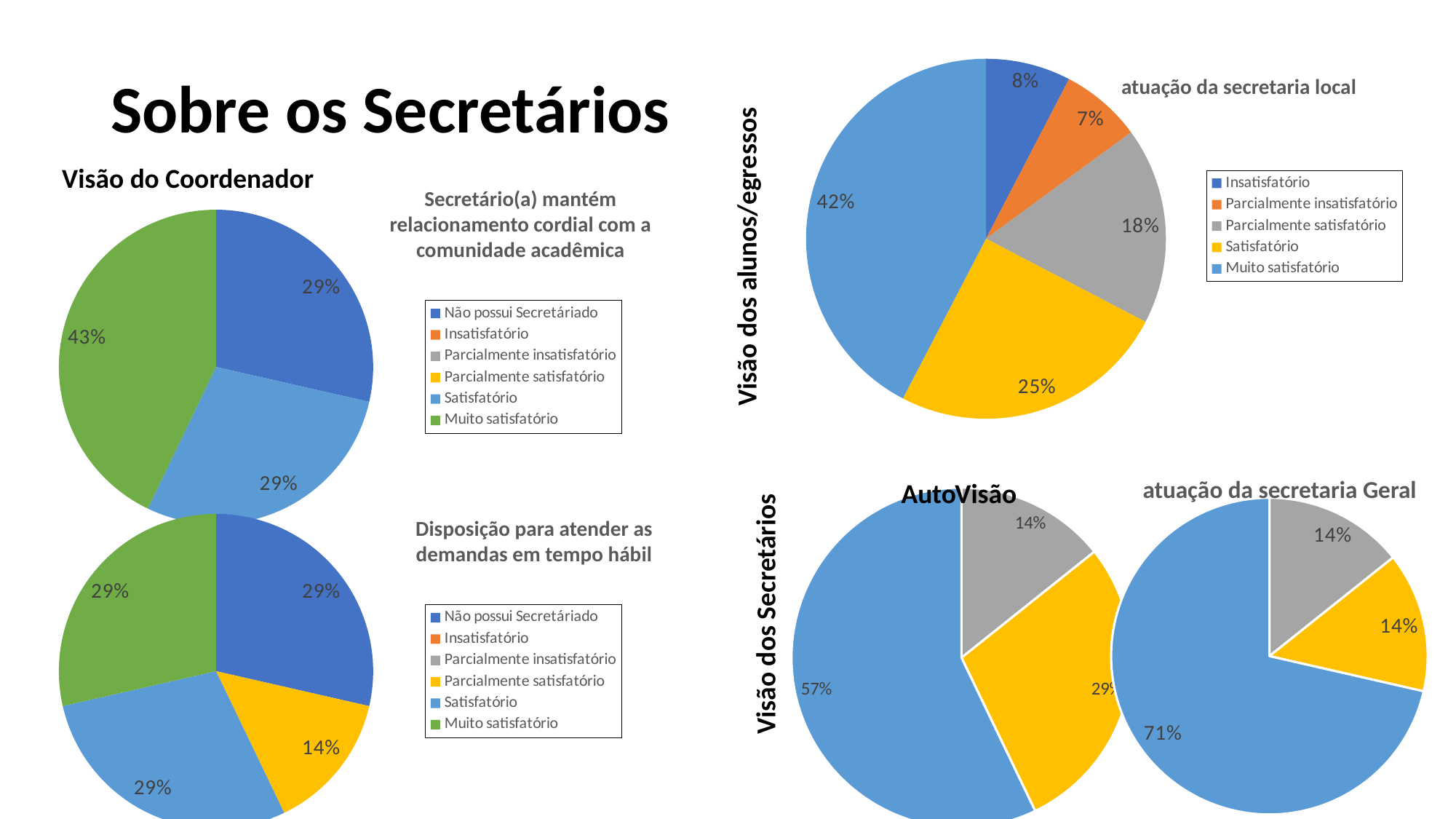
In the 'Disposição para atender as demandas em tempo hábil' pie chart, what share is labelled for the yellow 'Parcialmente satisfatório' slice? 14% In the 'atuação da secretaria local' pie chart, what share is labelled for the 'Muito satisfatório' slice? 42% In the 'AutoVisão' pie chart, what share is labelled for the largest (blue) slice? 57% How many slices does the 'Disposição para atender as demandas em tempo hábil' pie chart have? 4 How many slices does the 'Secretário(a) mantém relacionamento cordial com a comunidade acadêmica' pie chart have? 3 What type of chart is used for 'AutoVisão'? Pie chart In the 'atuação da secretaria local' pie chart, which legend category has the smallest slice? Parcialmente insatisfatório In the 'atuação da secretaria local' pie chart, what is the difference between the 'Satisfatório' slice and the 'Insatisfatório' slice? 17% In the 'Secretário(a) mantém relacionamento cordial com a comunidade acadêmica' pie chart, what share is labelled for the green 'Muito satisfatório' slice? 43% In the 'atuação da secretaria local' pie chart, what share is labelled for the 'Parcialmente satisfatório' slice? 18% How many entries does the legend of the 'atuação da secretaria local' pie chart list? 5 In the 'atuação da secretaria Geral' pie chart, what share is labelled for the blue slice? 71%